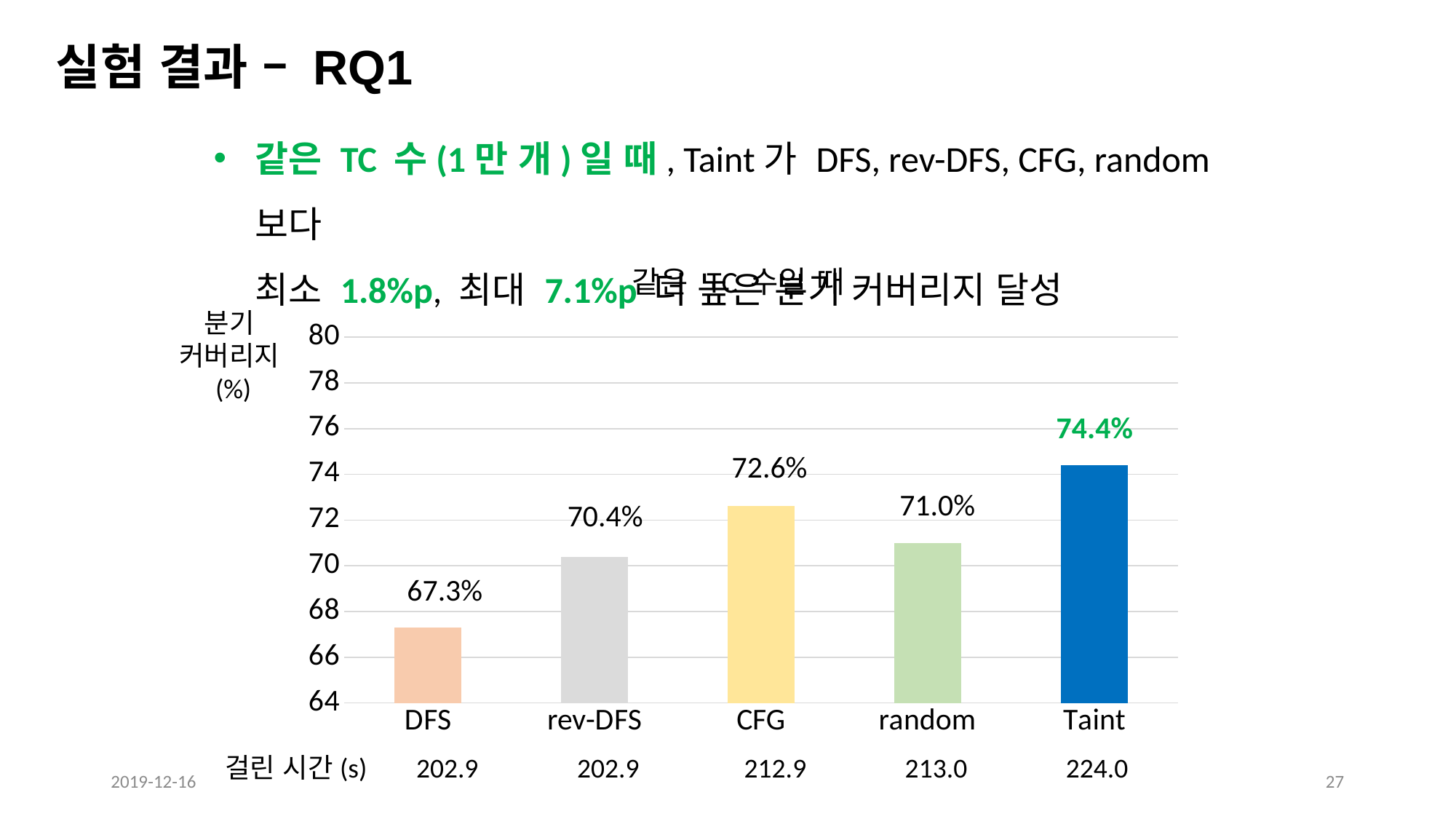
Which category has the highest branch coverage? Taint Which category has the lowest branch coverage? DFS What is the label of the y axis of the chart? 분기 커버리지 (%) What is the branch coverage value for Taint? 74.4% What is the difference in branch coverage between CFG and rev-DFS? 2.2% How many categories are shown on the x axis of the chart? 5 What kind of chart is shown on the slide? Bar chart What is the difference in branch coverage between Taint and DFS? 7.1% What is the branch coverage value for random? 71.0% What is the branch coverage value for DFS? 67.3% What is the branch coverage value for CFG? 72.6% Which has a higher branch coverage, CFG or random? CFG